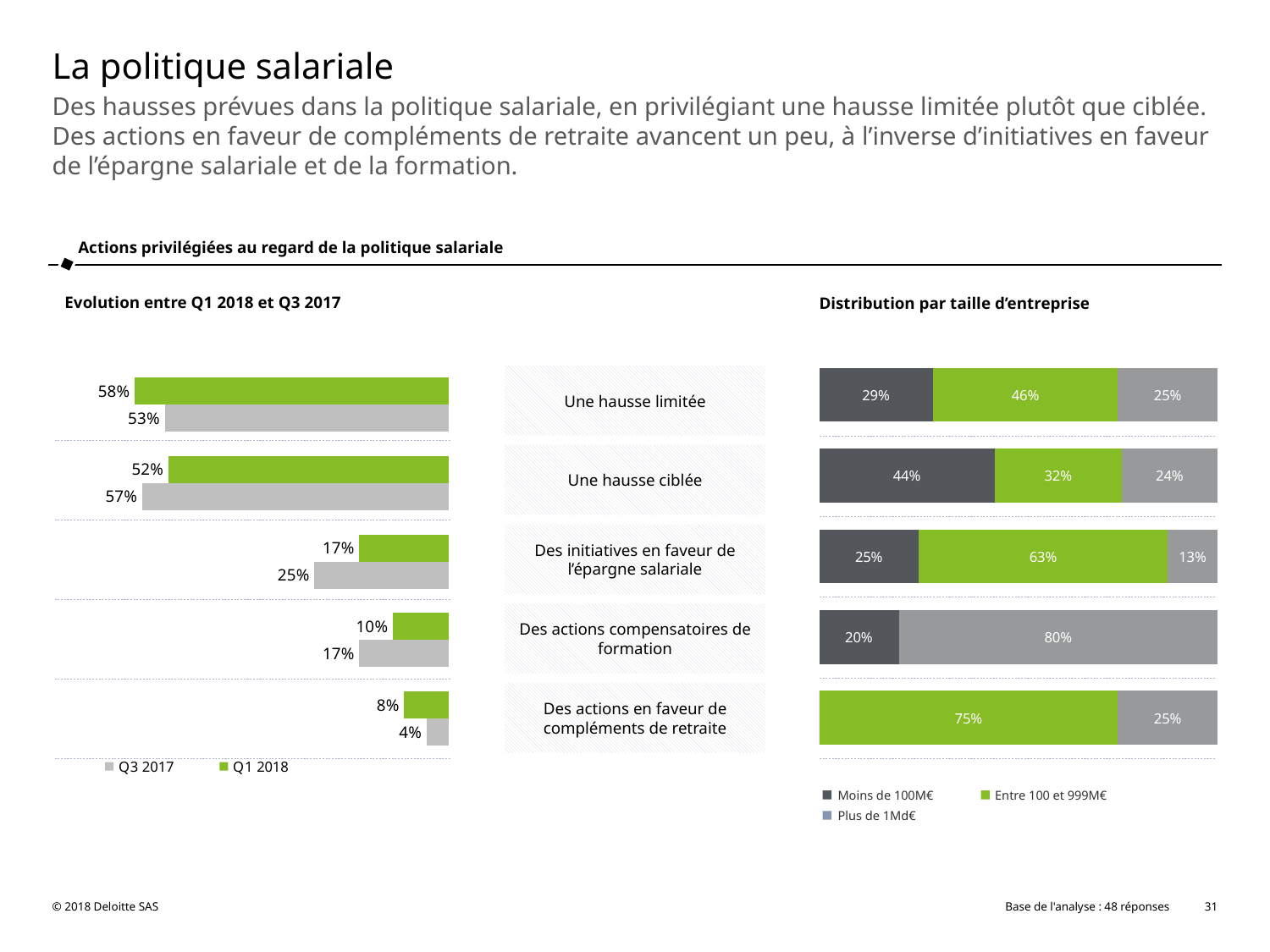
How many series does the legend of the chart 'Evolution entre Q1 2018 et Q3 2017' list? 2 In the chart 'Evolution entre Q1 2018 et Q3 2017', what is the Q3 2017 value for 'Une hausse ciblée'? 57% In the chart 'Distribution par taille d'entreprise', what is the 'Moins de 100M€' value for 'Une hausse ciblée'? 44% How many series does the legend of the chart 'Distribution par taille d'entreprise' list? 3 In the chart 'Evolution entre Q1 2018 et Q3 2017', which category has the highest Q1 2018 value? Une hausse limitée In the chart 'Evolution entre Q1 2018 et Q3 2017', what is the difference between the Q3 2017 and Q1 2018 values for 'Des initiatives en faveur de l'épargne salariale'? 8% What kind of chart is 'Distribution par taille d'entreprise'? Stacked bar chart In the chart 'Evolution entre Q1 2018 et Q3 2017', what is the Q1 2018 value for 'Une hausse limitée'? 58% In the chart 'Distribution par taille d'entreprise', what is the total of the stacked bar for 'Une hausse limitée'? 100% In the chart 'Evolution entre Q1 2018 et Q3 2017', which category has the lowest Q3 2017 value? Des actions en faveur de compléments de retraite In the chart 'Evolution entre Q1 2018 et Q3 2017', is the Q1 2018 value for 'Des actions compensatoires de formation' larger or smaller than its Q3 2017 value? smaller In the chart 'Distribution par taille d'entreprise', what is the 'Entre 100 et 999M€' value for 'Des initiatives en faveur de l'épargne salariale'? 63%